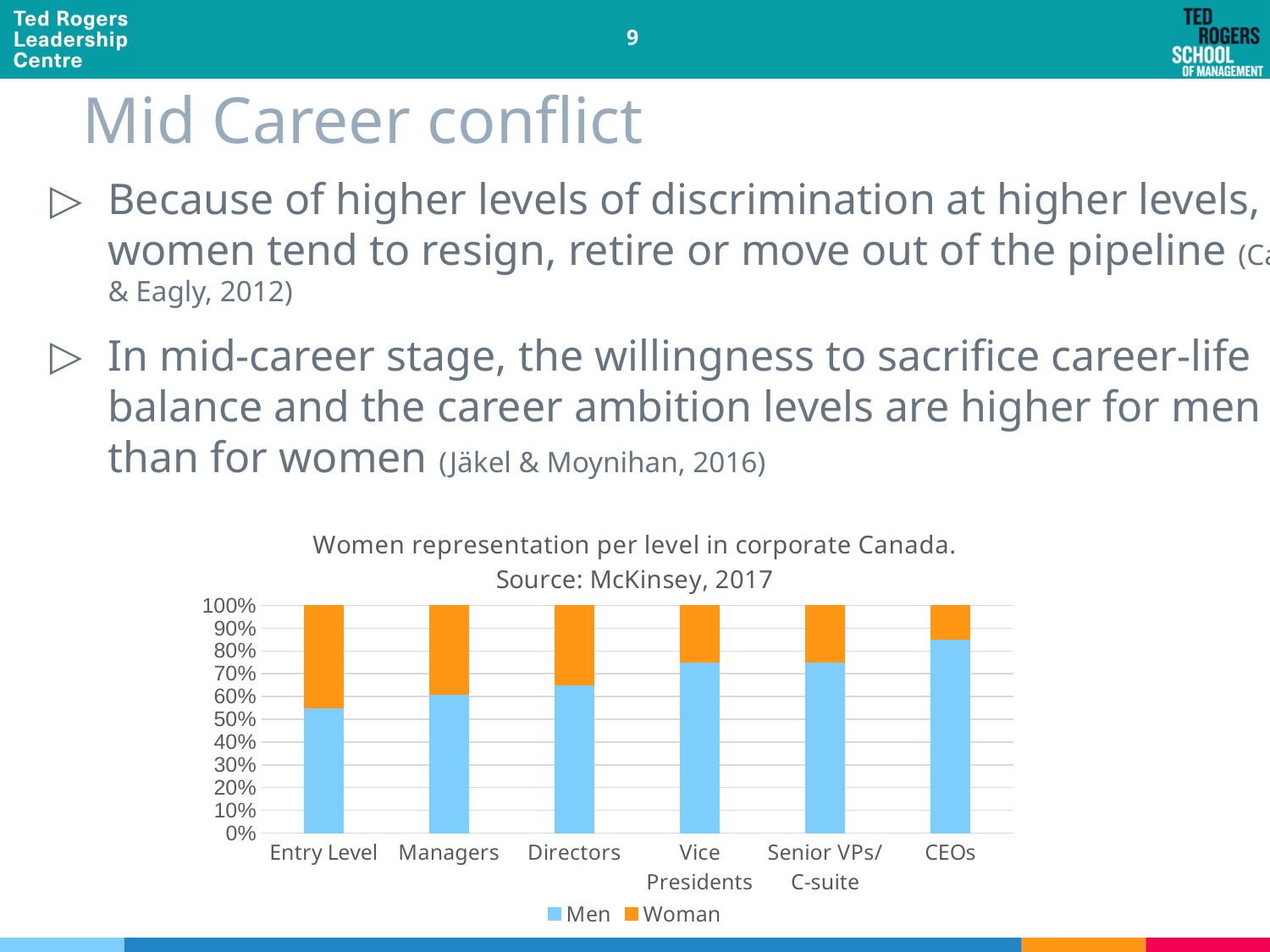
How many levels (categories) are shown on the x axis of the chart? 6 Which two series are listed in the chart legend? Men and Woman At which level is the Men share of the bar the smallest? Entry Level Is the Woman value for CEOs greater or less than 20%? less How many series does the chart legend list? 2 What is the title of the chart? Women representation per level in corporate Canada. Source: McKinsey, 2017 Is the Men value for Entry Level greater or less than 50%? greater Does the Men share rise or fall moving from Entry Level to CEOs along the x axis? rise Is the Men value for Directors greater or less than 60%? greater What kind of chart is shown on the slide? stacked bar chart At which level is the Woman share of the bar the largest? Entry Level